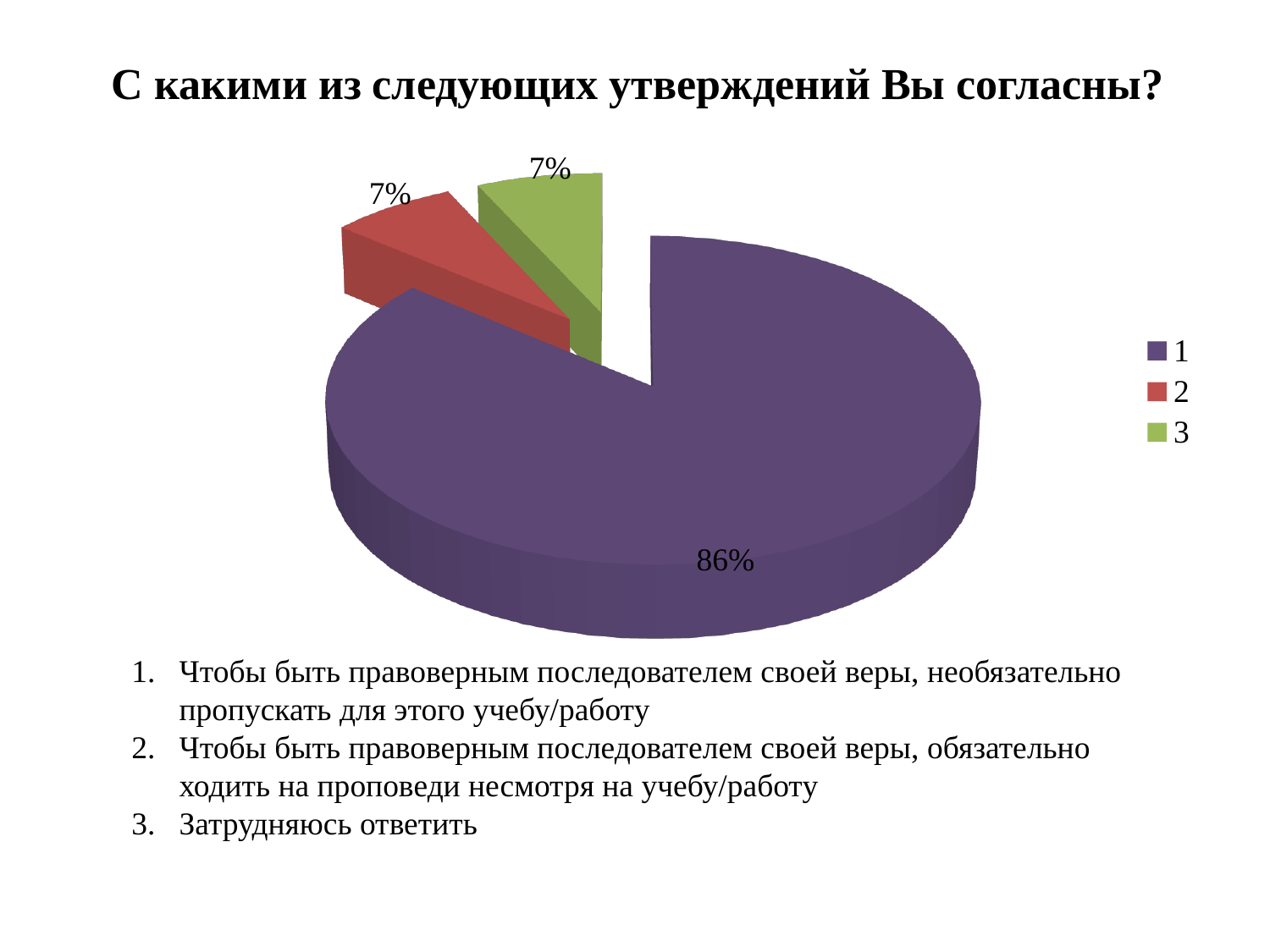
Which is larger, the slice for category 1 or the slice for category 3? 1 How many slices does the pie chart have? 3 What is the difference in percentage points between category 1 and category 2? 79 How many entries does the legend list? 3 What colour is the slice for category 1? purple What percentage is shown for category 1 in the pie chart? 86% What share of the pie does category 1 represent? 86% What percentage is shown for category 2 in the pie chart? 7% Which category has the largest slice in the pie chart? 1 What type of chart is shown on the slide? pie chart What is the title of the chart on the slide? С какими из следующих утверждений Вы согласны? What percentage is shown for category 3 in the pie chart? 7%